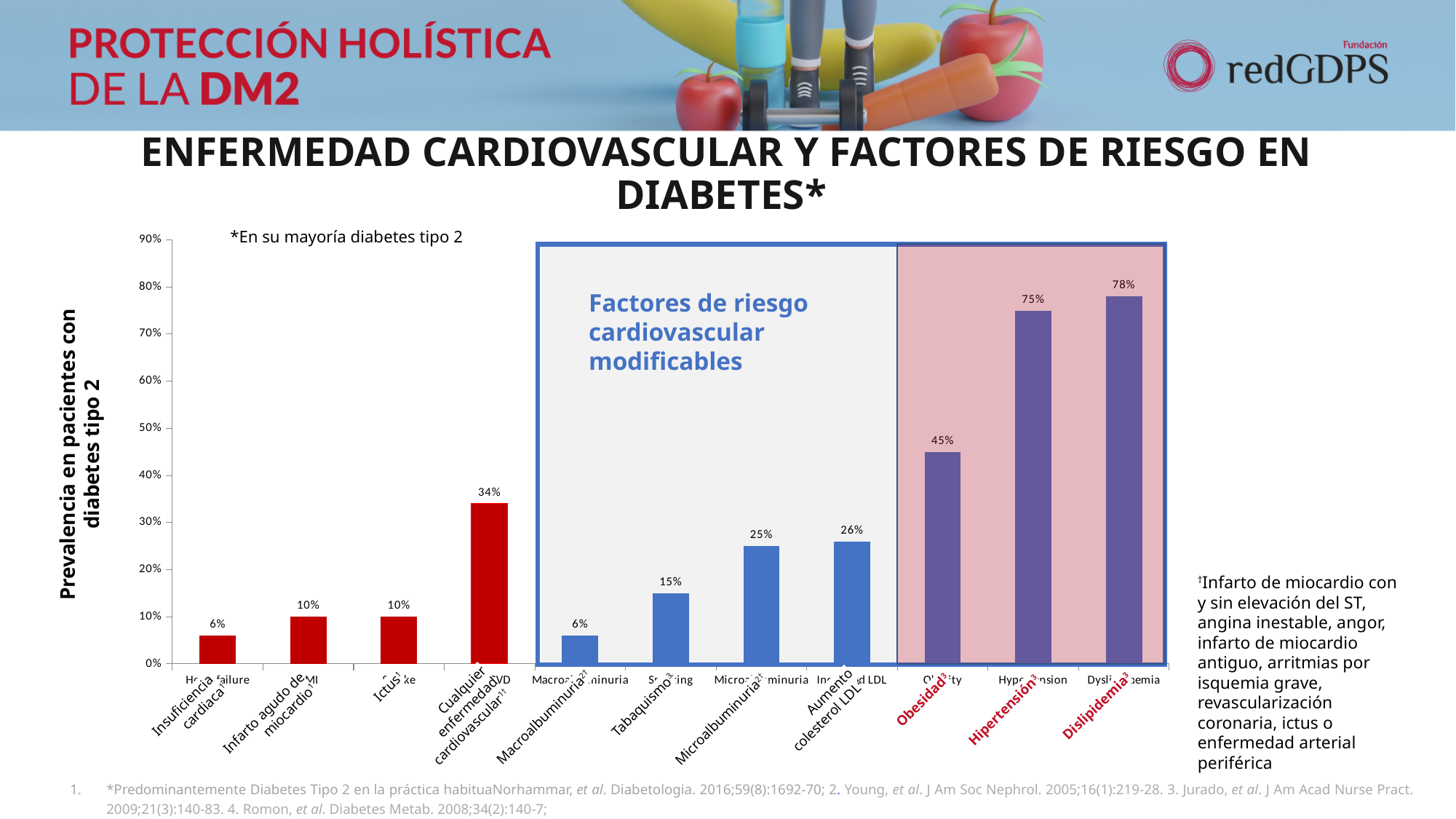
How many categories (bars) are plotted in the chart? 11 Which is larger, the prevalence of Obesidad or of Cualquier enfermedad cardiovascular? Obesidad What is the label of the vertical axis of the chart? Prevalencia en pacientes con diabetes tipo 2 What is the prevalence value shown for Hipertensión? 75% What is the prevalence value shown for Tabaquismo? 15% What is the prevalence value shown for Obesidad? 45% What type of chart is shown on the slide? Bar chart What is the prevalence value shown for Cualquier enfermedad cardiovascular? 34% What is the difference between the prevalence of Aumento colesterol LDL and Microalbuminuria? 1% Which category has the highest prevalence in the chart? Dislipidemia What is the difference between the prevalence of Dislipidemia and Hipertensión? 3% What is the prevalence value shown for Dislipidemia? 78%